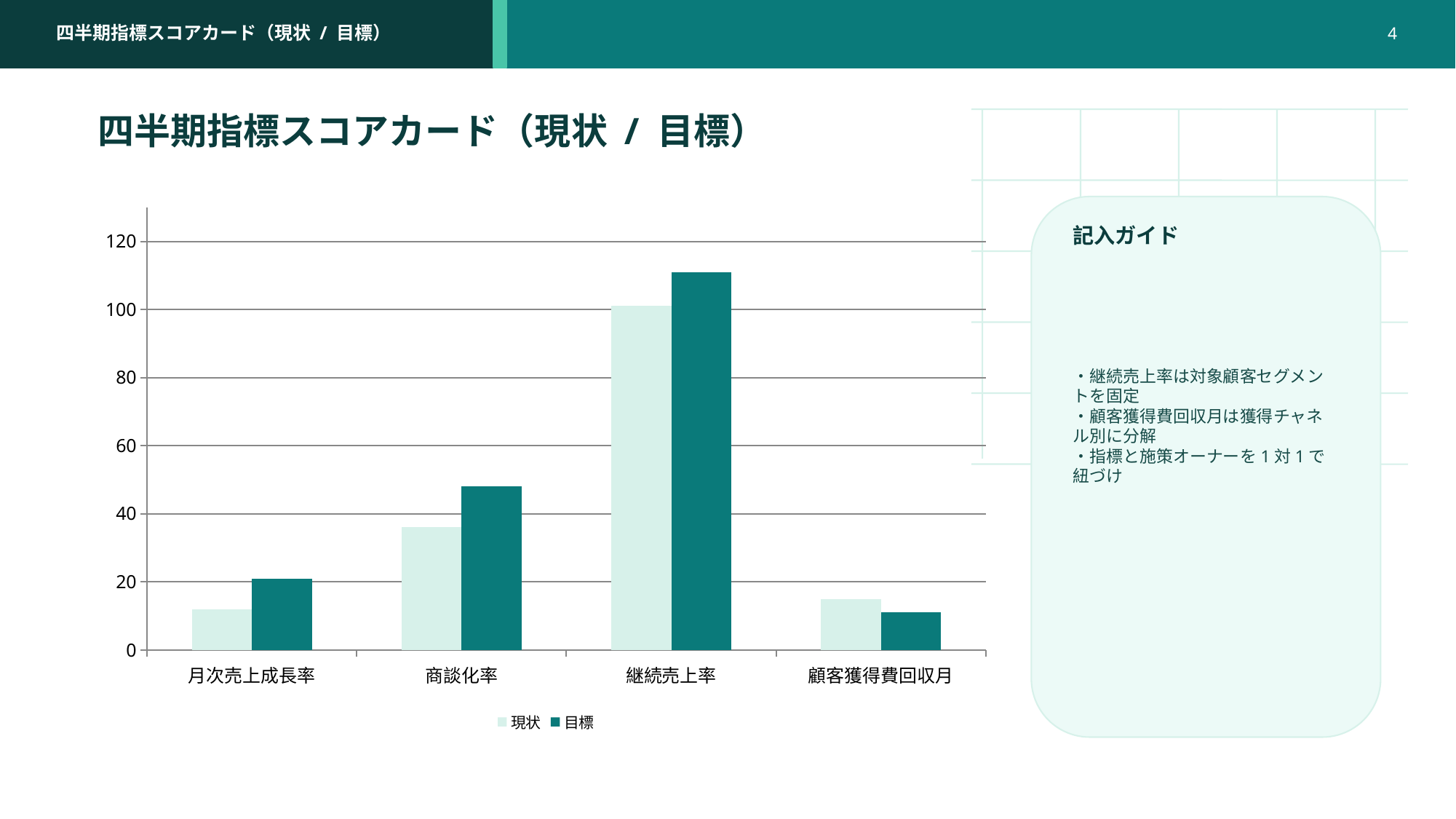
What are the two series names listed in the chart legend? 現状 and 目標 For 商談化率, which is larger, the 現状 value or the 目標 value? 目標 Which category has the lowest 現状 value? 月次売上成長率 Is the 現状 value for 月次売上成長率 greater or less than 20? less Which category has the highest 目標 value? 継続売上率 What kind of chart is shown on the slide? bar chart Is the 現状 value for 商談化率 greater or less than 40? less For 顧客獲得費回収月, which is larger, the 現状 value or the 目標 value? 現状 Is the 目標 value for 継続売上率 greater or less than 100? greater How many series does the chart legend list? 2 How many categories are shown on the x axis of the chart? 4